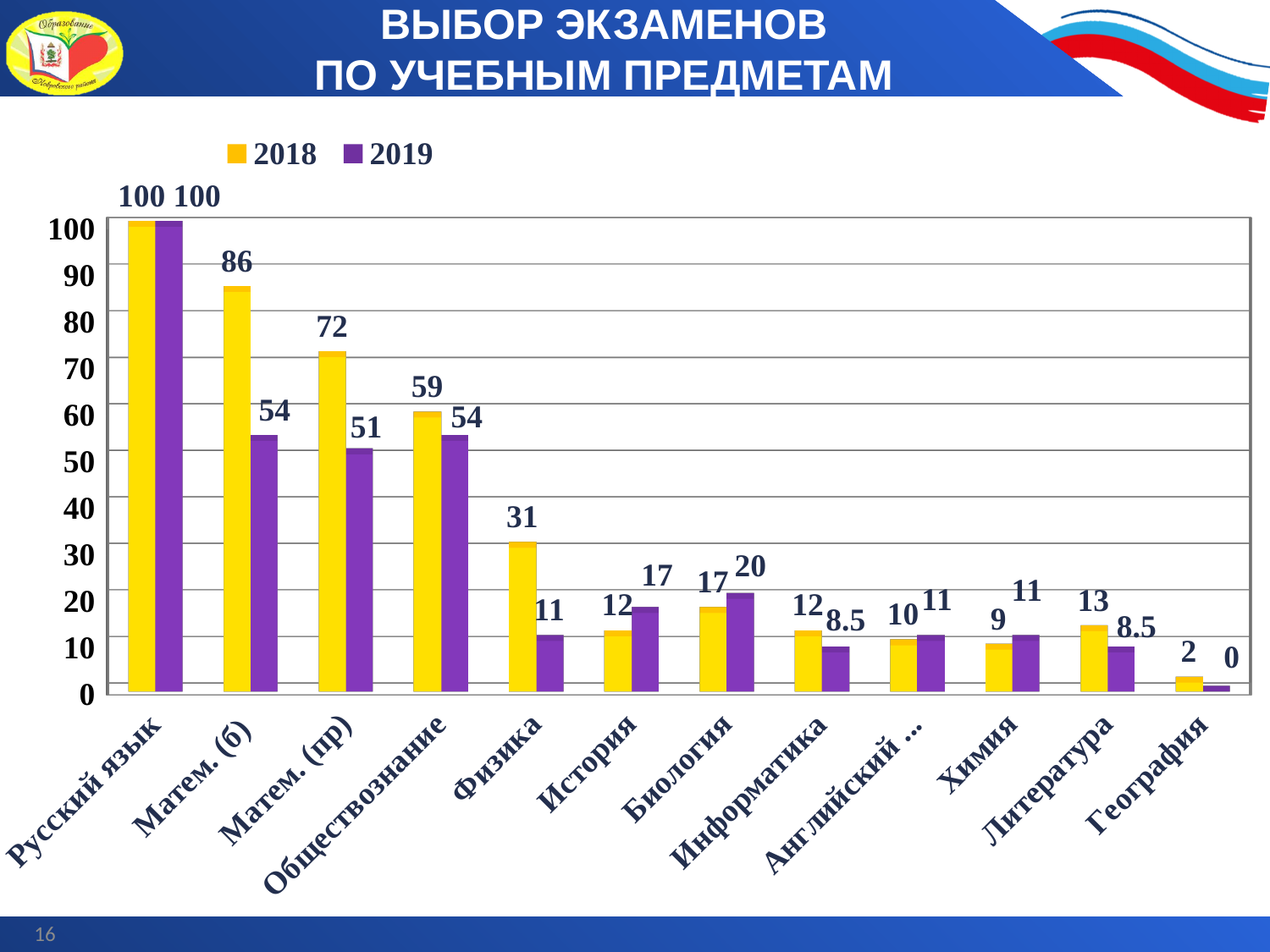
What is the title of the chart on the slide? ВЫБОР ЭКЗАМЕНОВ ПО УЧЕБНЫМ ПРЕДМЕТАМ Which subject has the lowest 2019 value? География What is the difference between the 2018 and 2019 values for Матем. (пр)? 21 Which subject has the highest 2018 value? Русский язык What is the 2018 value for Матем. (б)? 86 How many series does the legend list? 2 What is the 2019 value for Информатика? 8.5 What is the 2019 value for Физика? 11 For Биология, which year has the larger value, 2018 or 2019? 2019 Is the 2018 value for Обществознание greater or less than 50? greater How many subject categories are shown on the x axis? 12 What type of chart is shown on the slide? Bar chart